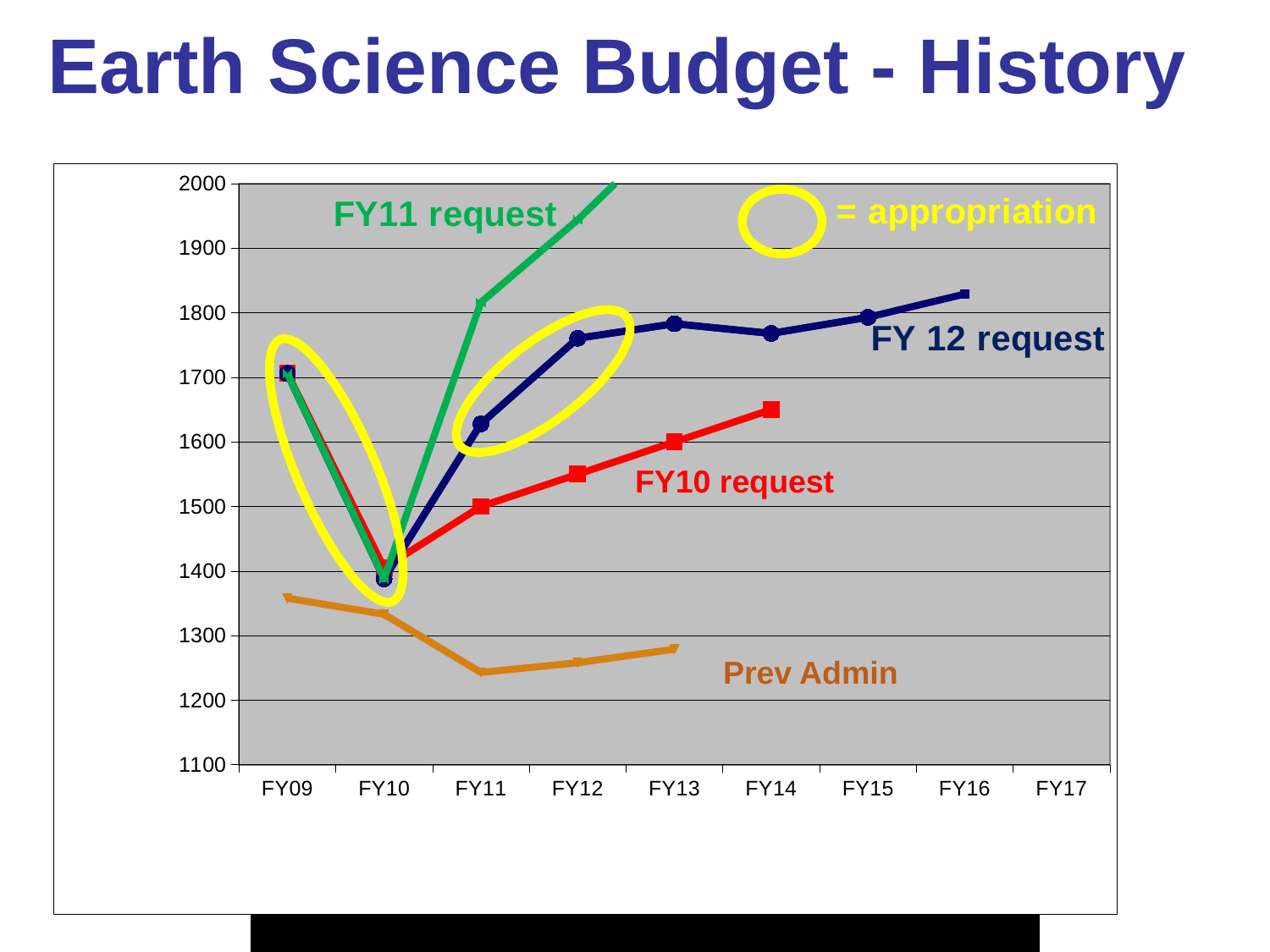
Which series reaches the highest value on the chart? FY11 request Is the value of the FY10 request line at FY14 greater or less than 1600? greater Is the value of the FY 12 request line at FY16 greater or less than 1800? greater According to the annotation, what do the yellow circles on the chart indicate? appropriation How many fiscal years are labelled on the x axis? 9 Is the value of the FY 12 request line at FY10 greater or less than 1500? less At FY12, which is larger: the FY11 request line or the FY10 request line? FY11 request At FY13, which is larger: the Prev Admin line or the FY 12 request line? FY 12 request How many data series are labelled on the chart? 4 What kind of chart is shown on the slide? line chart Does the Prev Admin line rise or fall from FY09 to FY11? fall